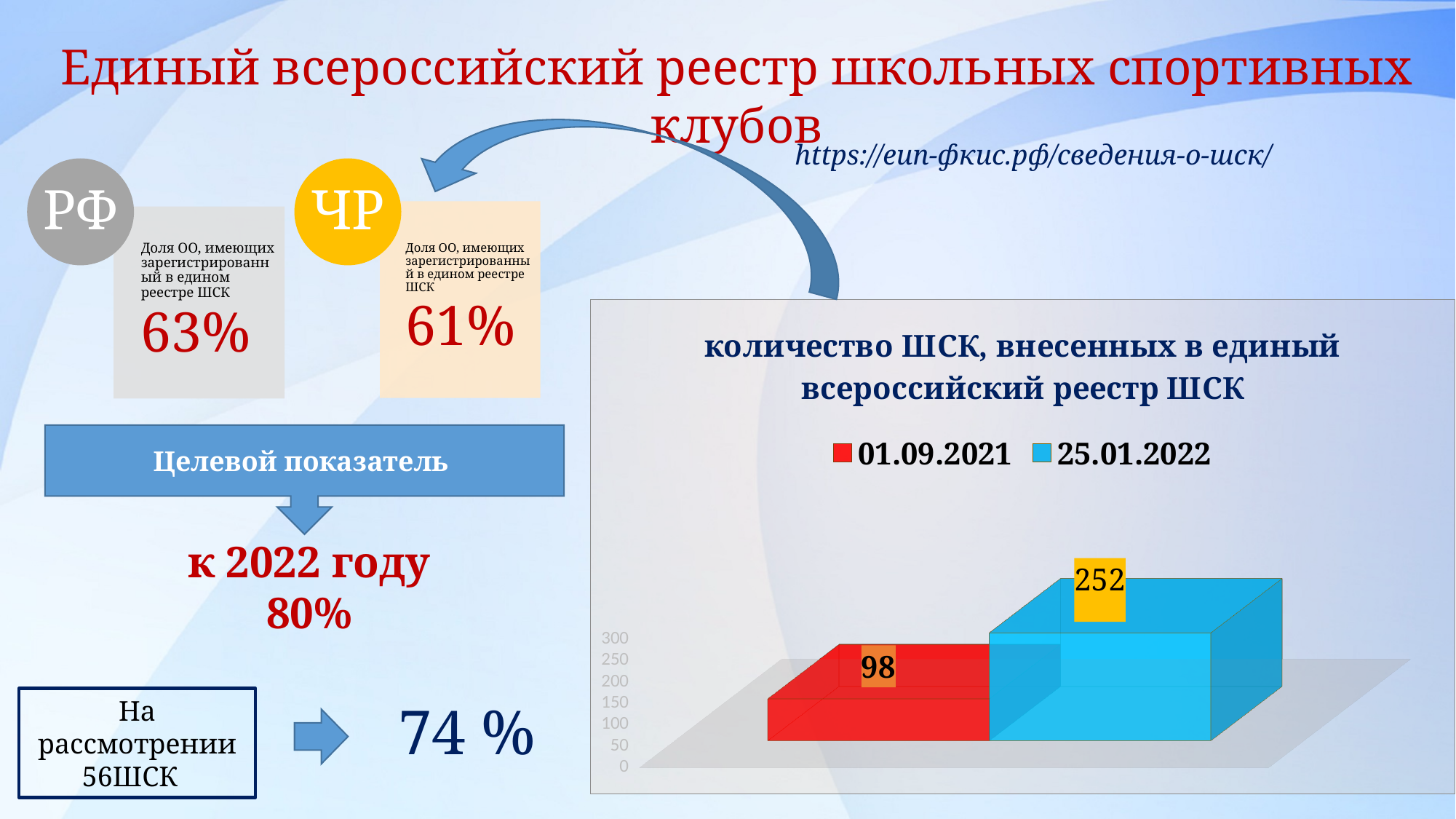
What kind of chart is shown on the slide? Bar chart What is the difference between the values for 25.01.2022 and 01.09.2021? 154 Which date has the lower value in the chart? 01.09.2021 Is the value for 01.09.2021 greater or less than 100? less What is the title of the chart? количество ШСК, внесенных в единый всероссийский реестр ШСК How many series does the chart legend list? 2 What is the value for 25.01.2022 in the chart? 252 Is the value for 25.01.2022 greater or less than 200? greater Which date has the higher value in the chart? 25.01.2022 What is the value for 01.09.2021 in the chart? 98 What colour is the bar for 25.01.2022? Blue Is the value for 25.01.2022 larger than the value for 01.09.2021? Yes